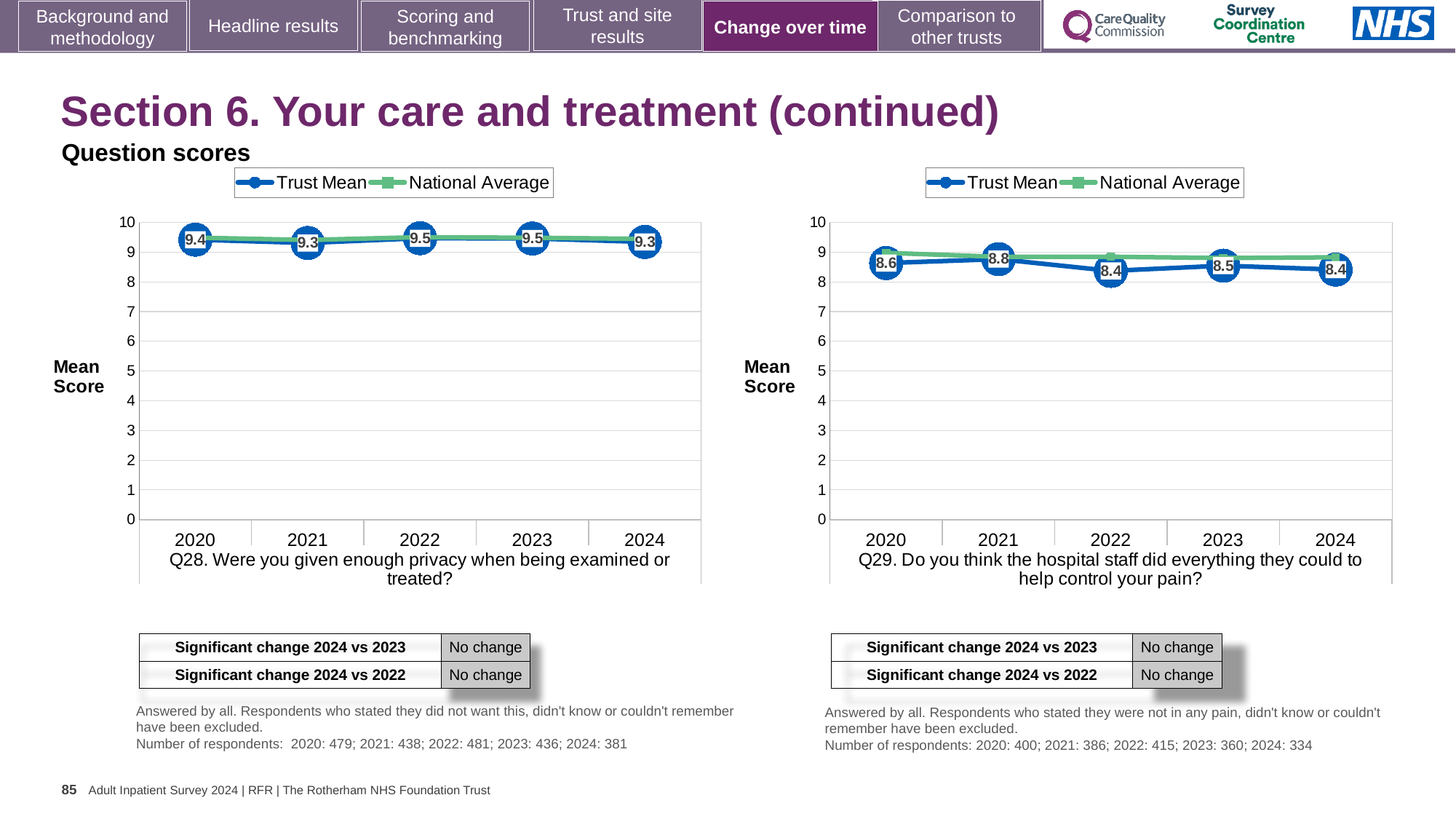
In the Q28 chart (left), is the Trust Mean value for 2021 greater or less than 9? greater In the Q29 chart (right), which year has the highest Trust Mean score? 2021 In the Q28 chart (left), what is the Trust Mean score for 2022? 9.5 How many series does the legend of the Q29 chart (right) list? 2 How many years are plotted on the x axis of the Q28 chart (left)? 5 In the Q29 chart (right), what is the Trust Mean score for 2024? 8.4 In the Q29 chart (right), is the Trust Mean score for 2020 larger or smaller than the Trust Mean score for 2021? smaller In the Q28 chart (left), what is the Trust Mean score for 2024? 9.3 In the Q28 chart (left), what is the difference between the Trust Mean scores for 2022 and 2024? 0.2 In the Q29 chart (right), what is the Trust Mean score for 2021? 8.8 In the Q29 chart (right), what is the difference between the Trust Mean scores for 2021 and 2022? 0.4 What kind of chart is the Q28 chart (left)? line chart